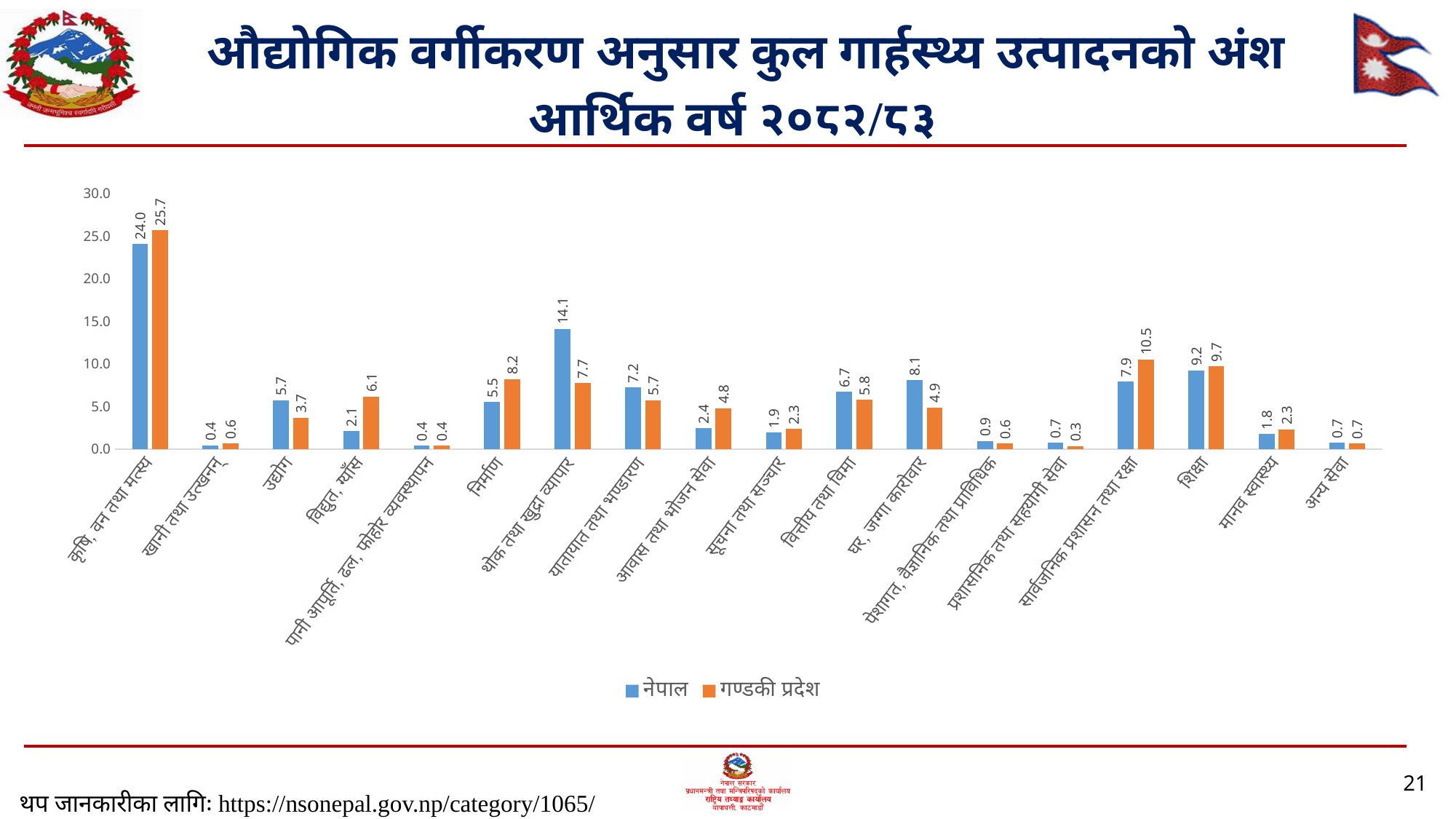
What is the value for नेपाल in the थोक तथा खुद्रा व्यापार category? 14.1 What type of chart is shown on the slide? bar chart What is the difference between the गण्डकी प्रदेश and नेपाल values in the निर्माण category? 2.7 How many series does the legend list? 2 Which category has the lowest value for गण्डकी प्रदेश? प्रशासनिक तथा सहयोगी सेवा Which category has the highest value for गण्डकी प्रदेश? कृषि, वन तथा मत्स्य In the विद्युत, ग्याँस category, which series has the larger value, नेपाल or गण्डकी प्रदेश? गण्डकी प्रदेश What is the value for गण्डकी प्रदेश in the सार्वजनिक प्रशासन तथा रक्षा category? 10.5 What is the value for नेपाल in the कृषि, वन तथा मत्स्य category? 24.0 How many categories are shown on the x axis? 18 Which colour represents the गण्डकी प्रदेश series? orange What is the difference between the नेपाल and गण्डकी प्रदेश values in the थोक तथा खुद्रा व्यापार category? 6.4